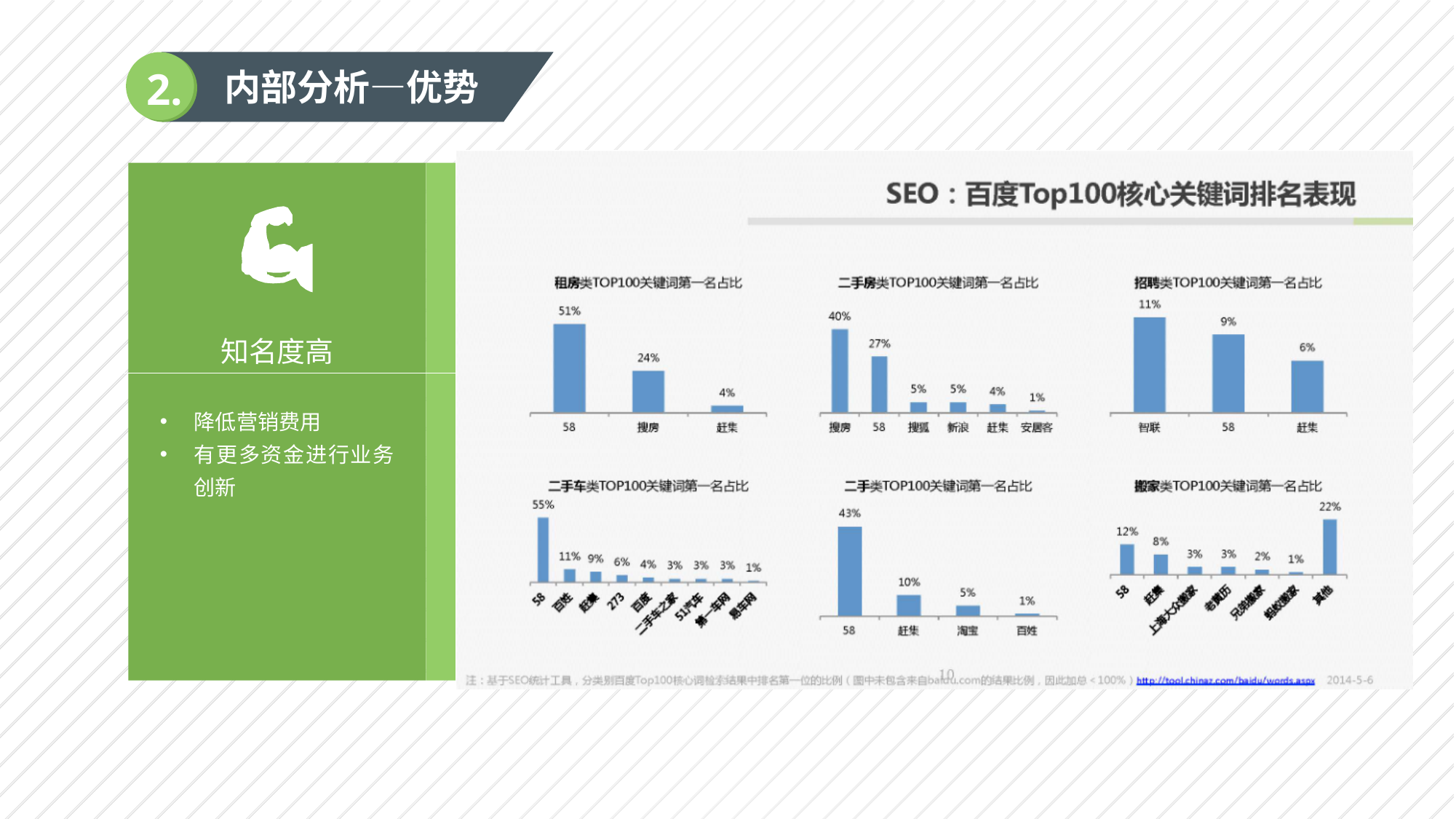
In the 二手房类TOP100关键词第一名占比 chart, which category has the highest value? 搜房 In the 招聘类TOP100关键词第一名占比 chart, what is the value for 智联? 11% What kind of chart is the 租房类TOP100关键词第一名占比 chart? bar chart In the 租房类TOP100关键词第一名占比 chart, what is the value for 58? 51% In the 二手车类TOP100关键词第一名占比 chart, what is the value for 58? 55% In the 二手房类TOP100关键词第一名占比 chart, how many categories are shown? 6 In the 招聘类TOP100关键词第一名占比 chart, which category has the lowest value? 赶集 In the 租房类TOP100关键词第一名占比 chart, what is the difference between 58 and 搜房? 27% In the 二手类TOP100关键词第一名占比 chart, which is larger, 赶集 or 淘宝? 赶集 In the 二手房类TOP100关键词第一名占比 chart, what is the value for 58? 27% In the 二手类TOP100关键词第一名占比 chart, what is the difference between 58 and 赶集? 33% In the 搬家类TOP100关键词第一名占比 chart, what is the value for 其他? 22%